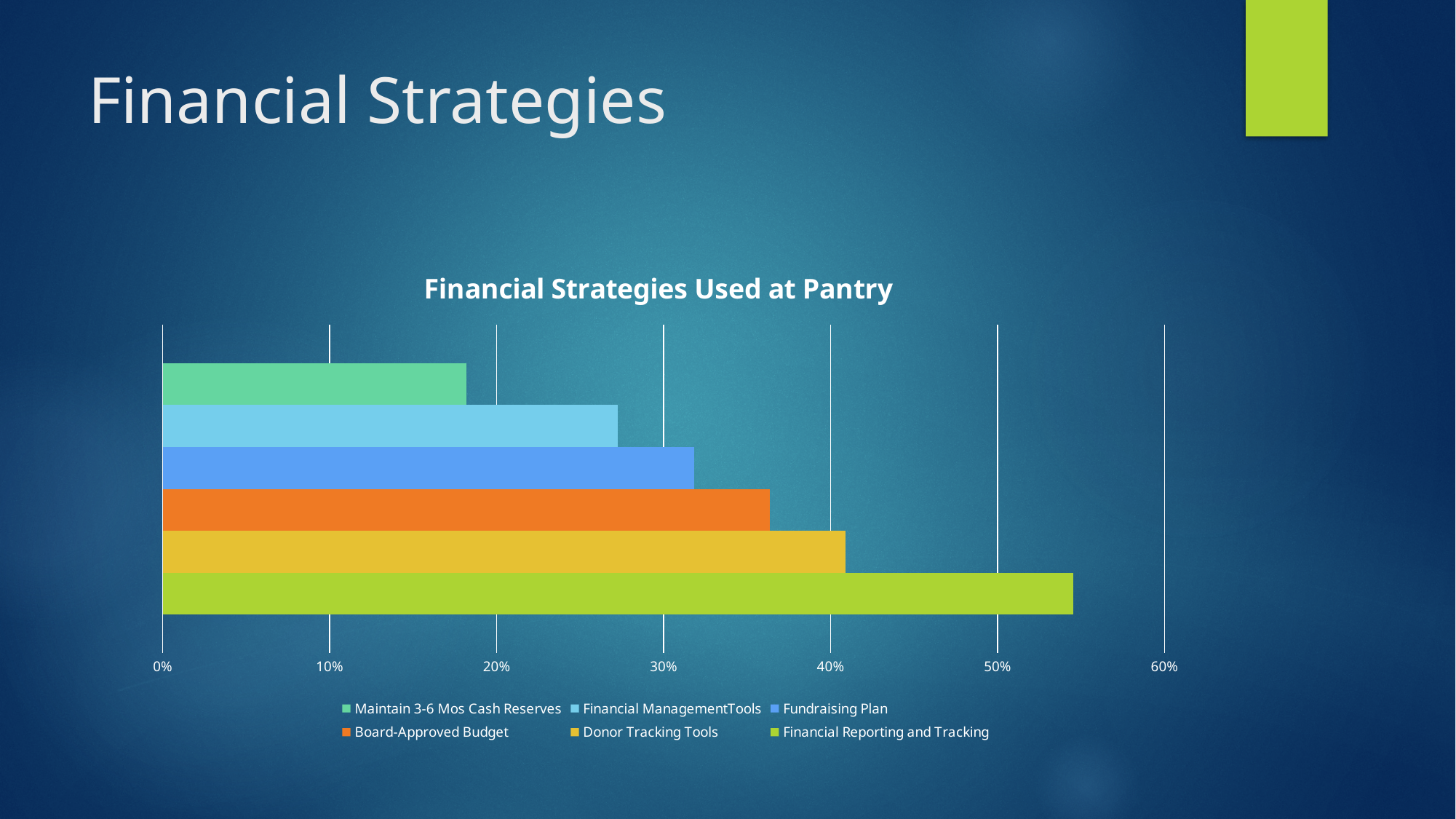
Which financial strategy has the lowest value? Maintain 3-6 Mos Cash Reserves How many bars are plotted in the chart? 6 What is the title of the chart? Financial Strategies Used at Pantry Is the value for Financial Management Tools greater or less than 20%? greater Is the value for Financial Reporting and Tracking greater or less than 50%? greater How many series does the legend list? 6 Is the value for Board-Approved Budget greater or less than 40%? less Which is larger, the value for Donor Tracking Tools or the value for Fundraising Plan? Donor Tracking Tools What colour is the bar for Board-Approved Budget? Orange What type of chart is shown on the slide? Bar chart Which financial strategy has the highest value? Financial Reporting and Tracking